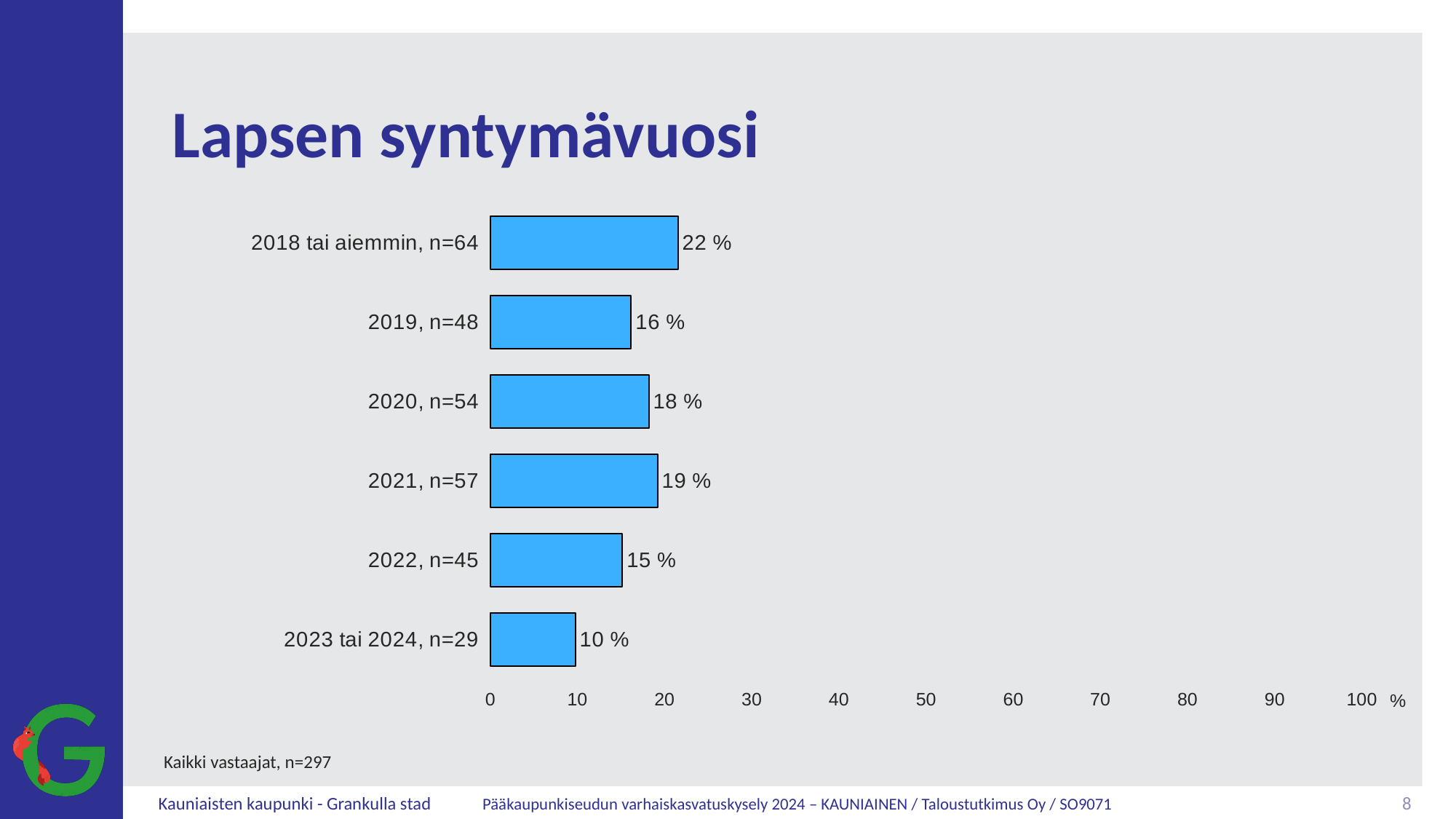
What is the title of the chart on the slide? Lapsen syntymävuosi What is the value for the category "2022, n=45"? 15 % How many categories are shown in the chart? 6 Which is larger, the value for "2021, n=57" or the value for "2022, n=45"? 2021, n=57 What is the value for the category "2018 tai aiemmin, n=64"? 22 % Is the value for "2018 tai aiemmin, n=64" greater or less than 20? greater Which category has the lowest value? 2023 tai 2024, n=29 What is the difference between the values for "2018 tai aiemmin, n=64" and "2023 tai 2024, n=29"? 12 % What is the value for the category "2021, n=57"? 19 % Which category has the highest value? 2018 tai aiemmin, n=64 What is the difference between the values for "2020, n=54" and "2019, n=48"? 2 % What kind of chart is shown on the slide? Bar chart